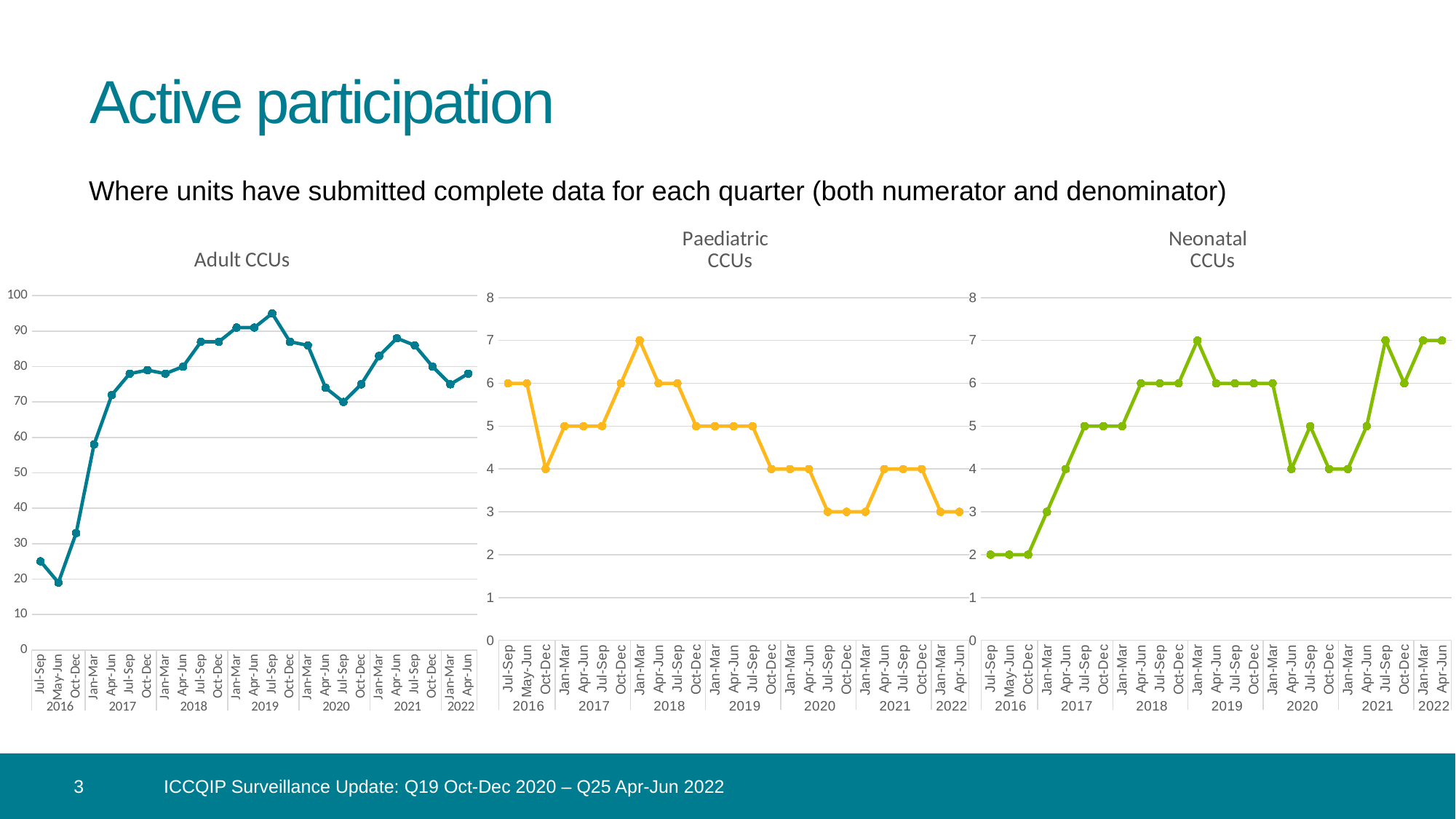
What type of chart is used for the Adult CCUs panel? line chart How many charts are shown on the slide? 3 In the Adult CCUs chart, is the value for Jul-Sep 2019 greater or less than 90? greater In the Neonatal CCUs chart, what is the value for Apr-Jun 2022? 7 In the Neonatal CCUs chart, what is the value for Jul-Sep 2016? 2 In the Adult CCUs chart, is the value for May-Jun 2016 greater or less than 30? less In the Neonatal CCUs chart, do the values generally rise or fall from 2016 to 2019? rise In the Paediatric CCUs chart, which is larger: the value for Oct-Dec 2017 or the value for Oct-Dec 2019? Oct-Dec 2017 In the Paediatric CCUs chart, what is the value for Jan-Mar 2018? 7 In the Paediatric CCUs chart, what is the value for Oct-Dec 2016? 4 In the Paediatric CCUs chart, which quarter has the highest value? Jan-Mar 2018 In the Neonatal CCUs chart, what is the difference between the value for Jan-Mar 2019 and the value for Apr-Jun 2020? 3